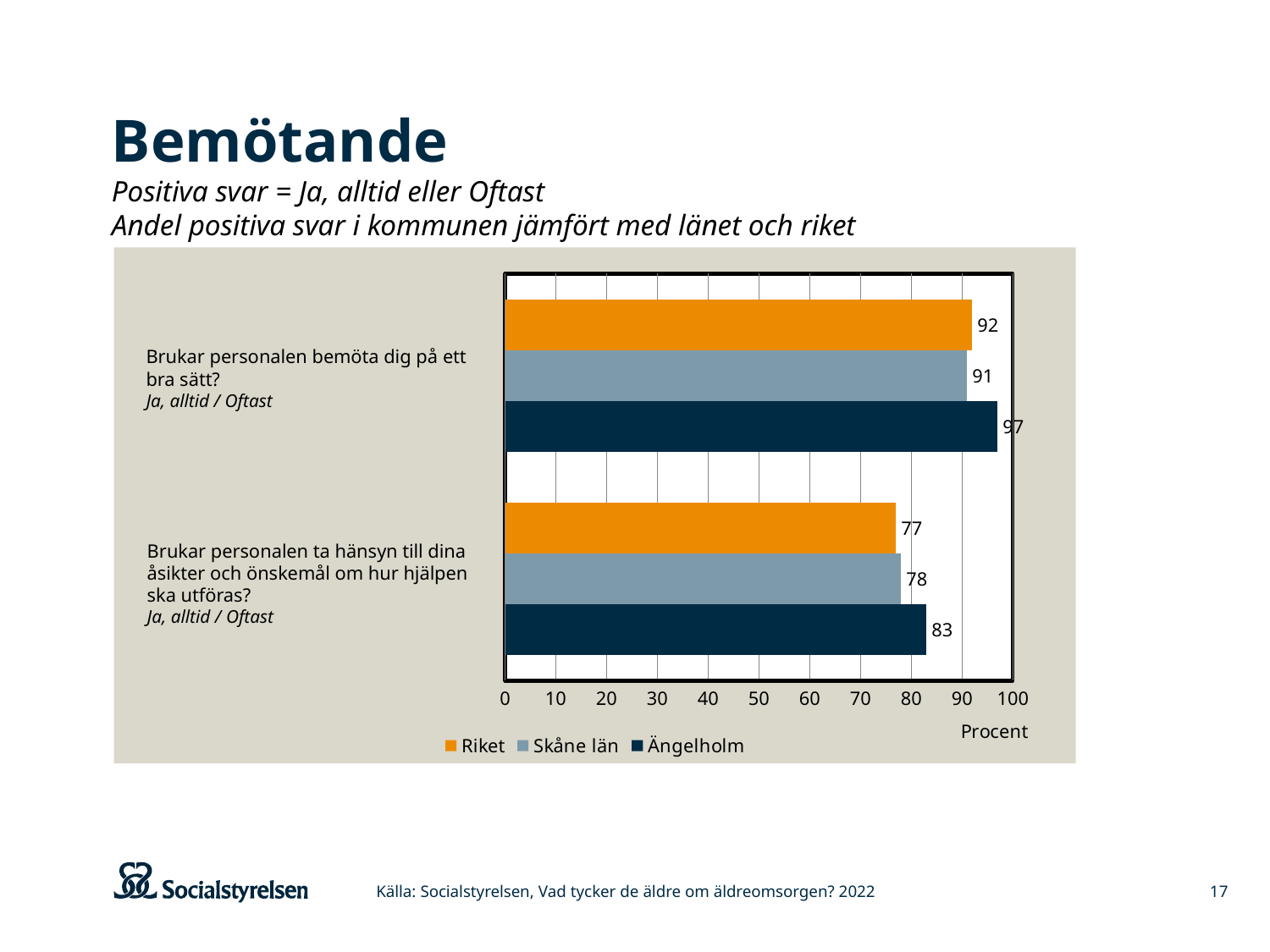
What kind of chart is shown on the slide? Bar chart What is the difference between Ängelholm and Skåne län on "Brukar personalen ta hänsyn till dina åsikter och önskemål om hur hjälpen ska utföras?" 5 What is the value for Riket on "Brukar personalen ta hänsyn till dina åsikter och önskemål om hur hjälpen ska utföras?" 77 What is the label on the horizontal axis of the chart? Procent Which series has the highest value on "Brukar personalen bemöta dig på ett bra sätt?" Ängelholm What is the value for Skåne län on "Brukar personalen ta hänsyn till dina åsikter och önskemål om hur hjälpen ska utföras?" 78 What is the value for Skåne län on "Brukar personalen bemöta dig på ett bra sätt?" 91 Which series has the lowest value on "Brukar personalen ta hänsyn till dina åsikter och önskemål om hur hjälpen ska utföras?" Riket How many series does the legend list? 3 What is the value for Ängelholm on "Brukar personalen bemöta dig på ett bra sätt?" 97 What is the difference between Ängelholm and Riket on "Brukar personalen bemöta dig på ett bra sätt?" 5 Which is larger for Ängelholm: the value on "Brukar personalen bemöta dig på ett bra sätt?" or on "Brukar personalen ta hänsyn till dina åsikter och önskemål om hur hjälpen ska utföras?" Brukar personalen bemöta dig på ett bra sätt?